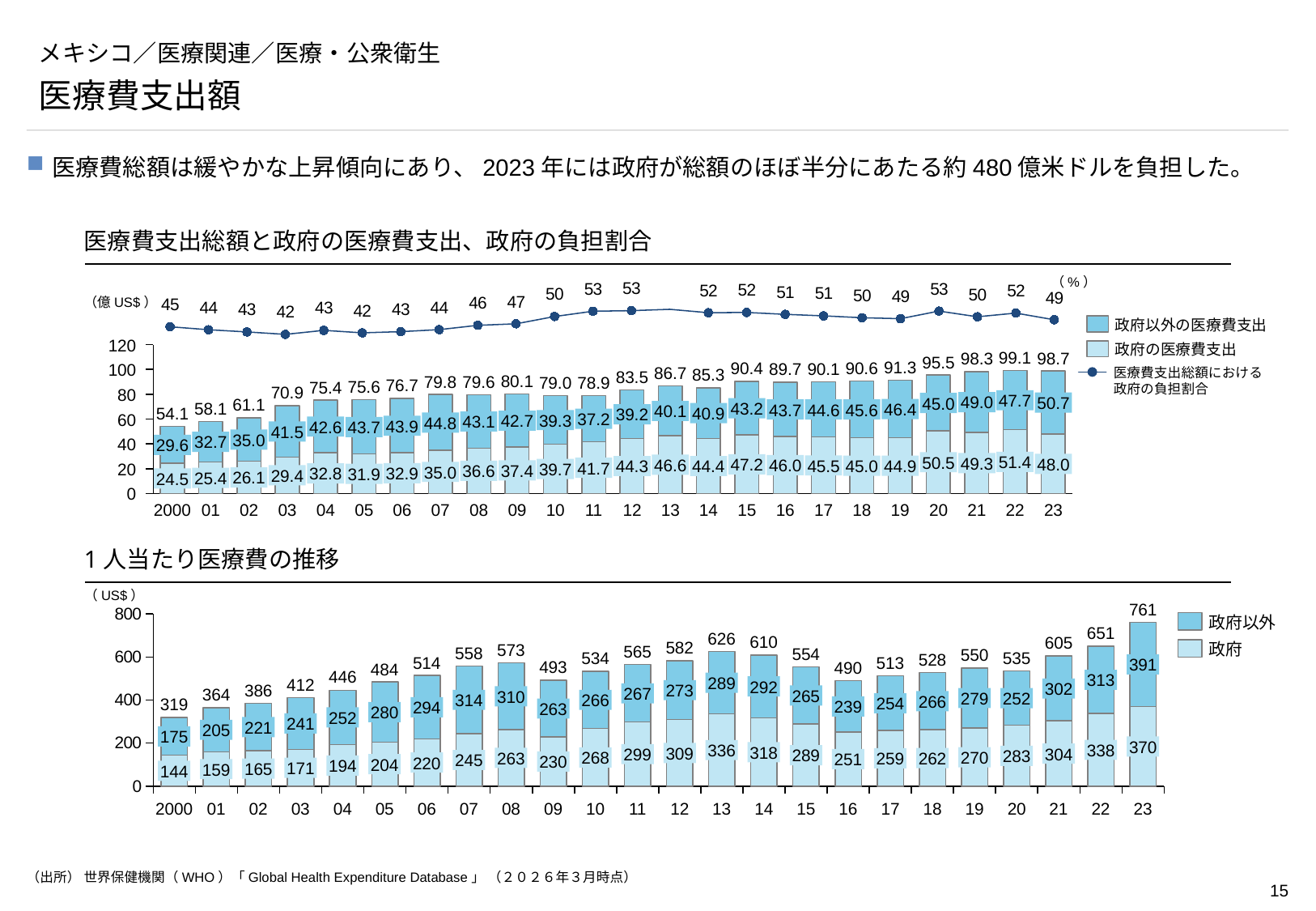
In the top chart, how many series does the legend list? 3 In the top chart (医療費支出総額と政府の医療費支出、政府の負担割合), what is the total health expenditure for 2023? 98.7 In the bottom chart, what is the difference between the non-government (政府以外) and government (政府) per-capita values in 2023? 21 What kind of chart is the bottom chart (1人当たり医療費の推移)? Stacked bar chart In the bottom chart, which year has the lowest total per-capita health expenditure? 2000 In the bottom chart, how many years are plotted on the x axis? 24 In the bottom chart (1人当たり医療費の推移), what is the total per-capita health expenditure in 2023? 761 In the top chart, which year has the lowest total health expenditure? 2000 In the top chart, what is the government's share of total health expenditure (政府の負担割合) in 2023? 49 In the top chart, which year has the highest total health expenditure? 2022 In the bottom chart, what is the government (政府) per-capita health expenditure in 2000? 144 In the top chart, in 2023, which is larger: government health expenditure (政府の医療費支出) or non-government health expenditure (政府以外の医療費支出)? 政府以外の医療費支出